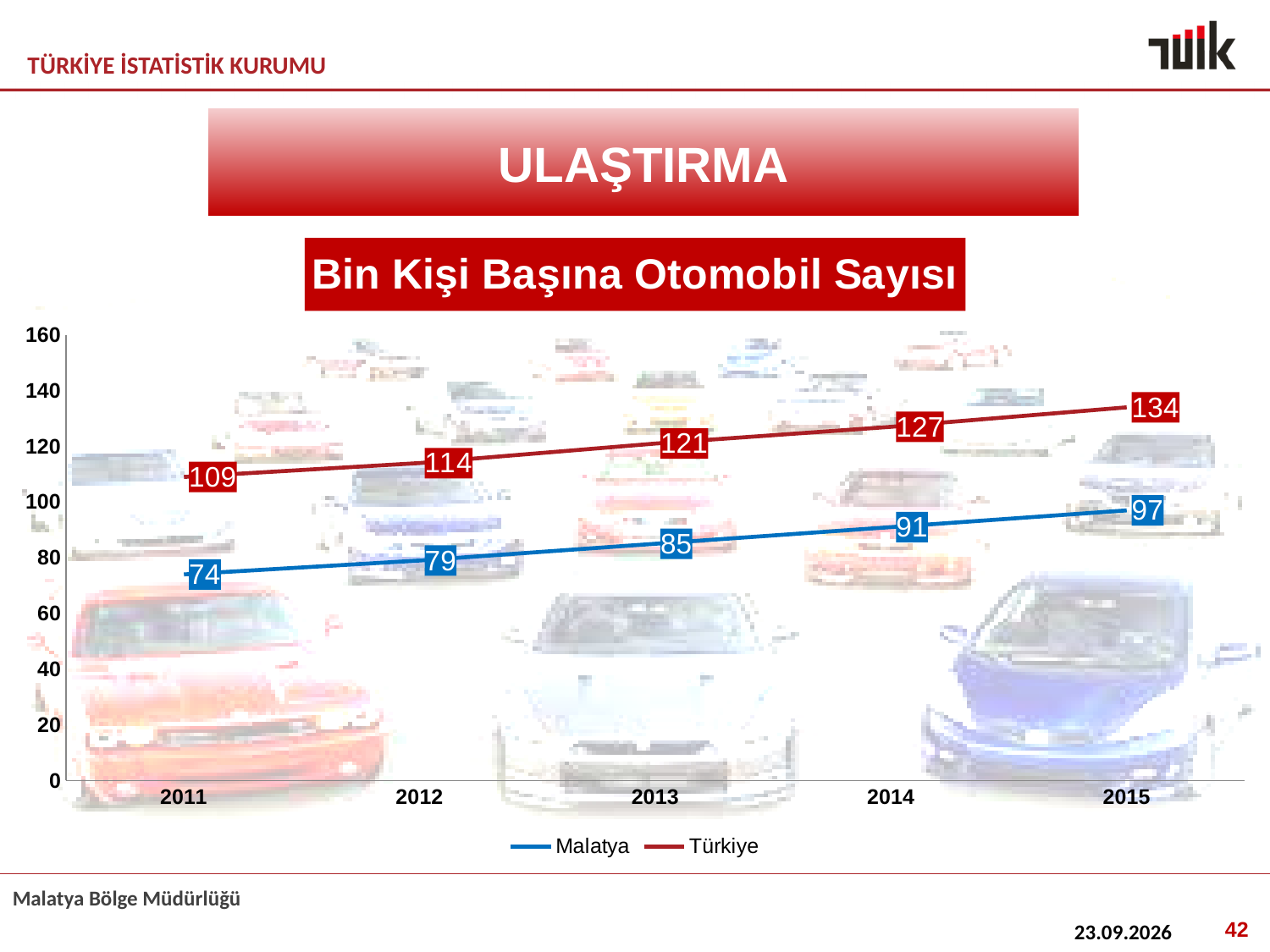
What is the value for Malatya in 2013? 85 Which is larger in 2013, the Malatya value or the Türkiye value? Türkiye What is the difference between the Türkiye and Malatya values in 2014? 36 Do the Malatya values rise or fall from 2011 to 2015? rise What is the value for Türkiye in 2012? 114 How many series does the legend list? 2 In which year is the Türkiye value lowest? 2011 In which year is the Malatya value highest? 2015 What kind of chart is shown? line chart How many years are shown on the x axis? 5 What is the value for Malatya in 2011? 74 What is the value for Türkiye in 2015? 134